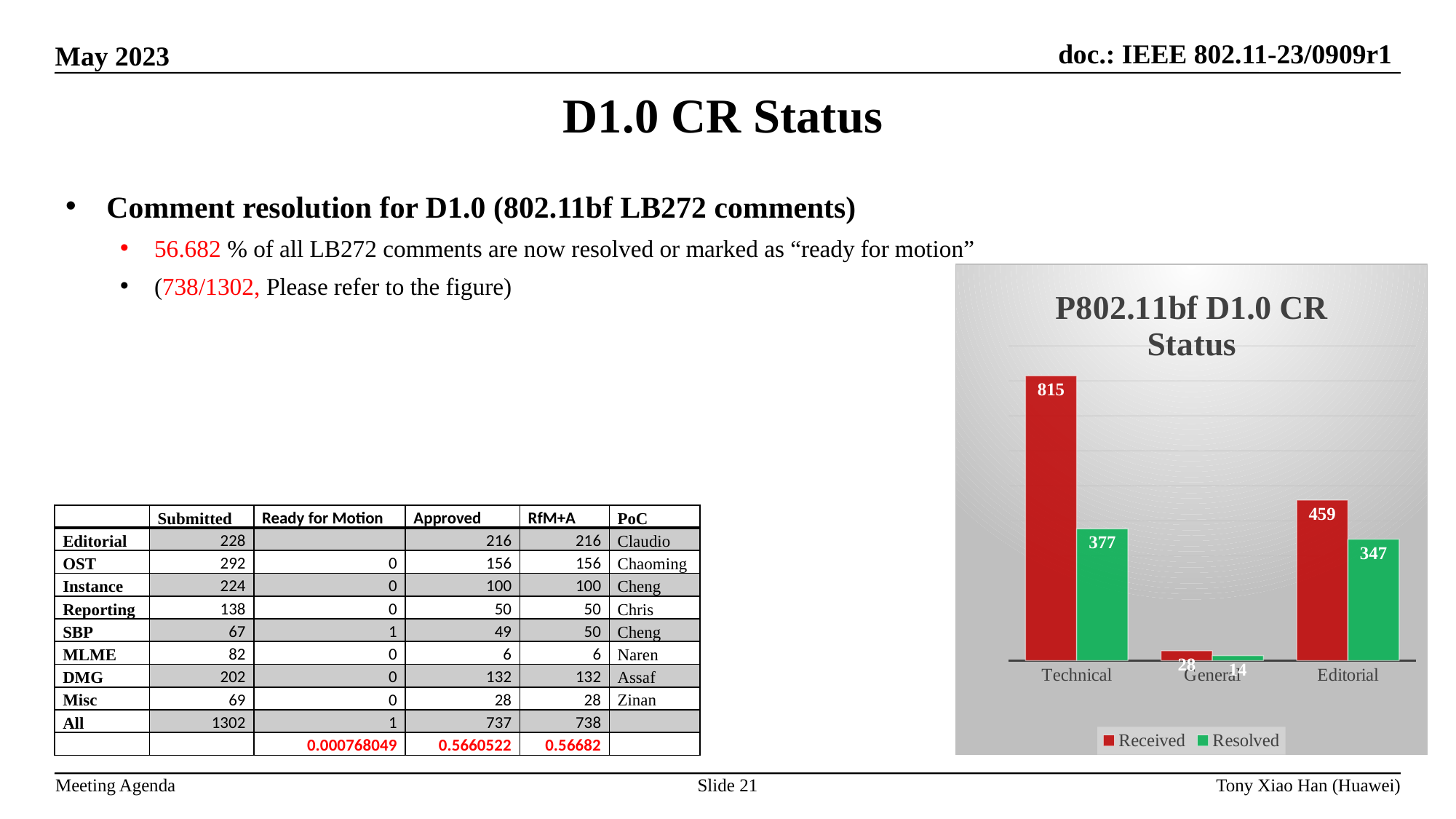
What is the difference between Received and Resolved for Editorial? 112 Which category has the lowest Resolved value? General What is the Resolved value for General? 14 What is the Received value for Technical? 815 How many series does the chart legend list? 2 What is the Received value for Editorial? 459 What is the Resolved value for Editorial? 347 Which category has the highest Received value? Technical How many categories are shown on the x axis of the chart? 3 What type of chart is shown on the slide? bar chart Which is larger, the Resolved value for Technical or the Resolved value for Editorial? Technical What is the difference between Received and Resolved for Technical? 438